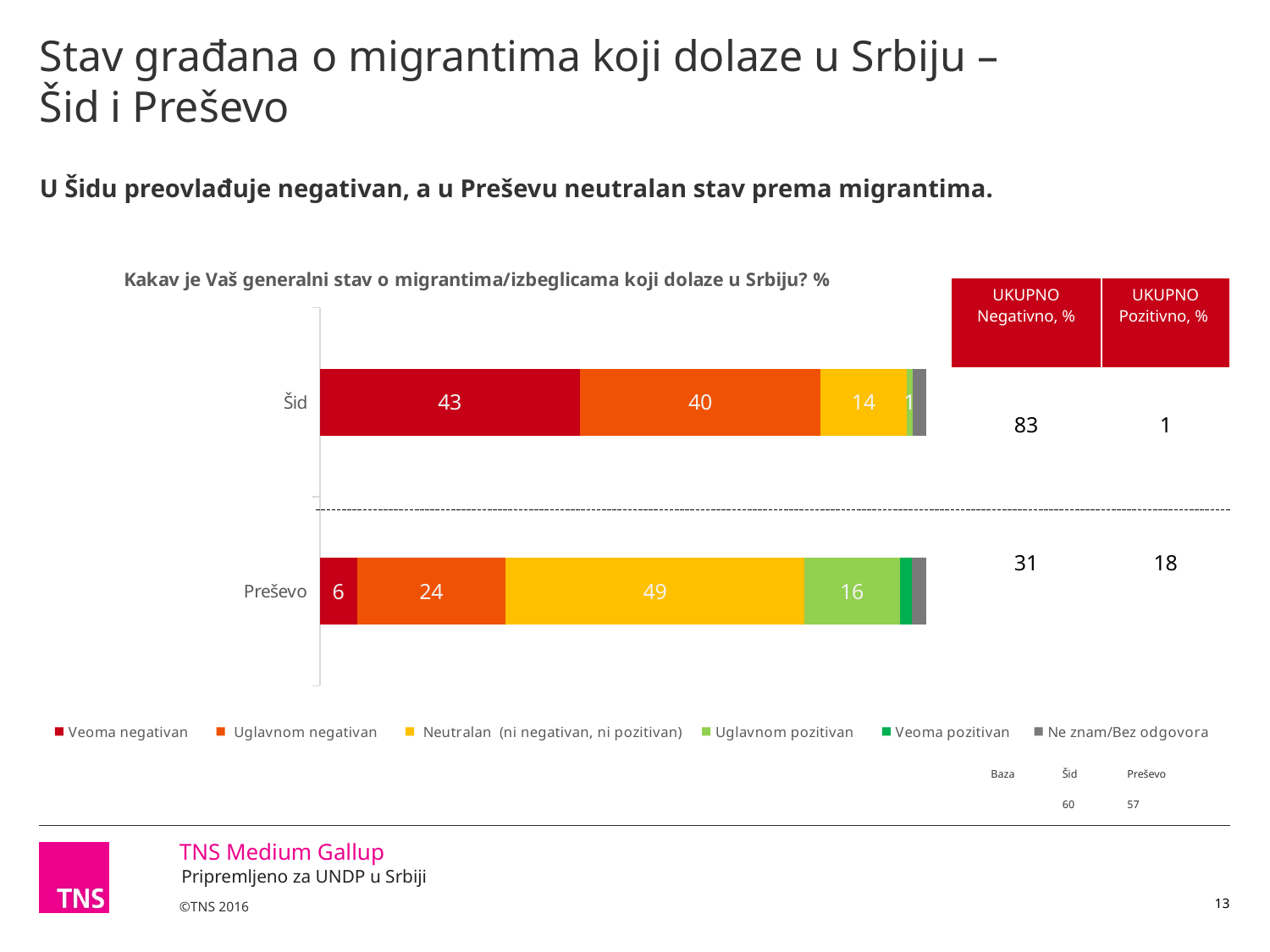
What is the value of 'Uglavnom negativan' for Šid? 40 What is the value of 'Uglavnom pozitivan' for Preševo? 16 What is the difference between the 'Neutralan' values for Preševo and Šid? 35 What is the value of 'Neutralan (ni negativan, ni pozitivan)' for Preševo? 49 What is the difference between the 'Veoma negativan' values for Šid and Preševo? 37 What is the title of the chart? Kakav je Vaš generalni stav o migrantima/izbeglicama koji dolaze u Srbiju? % What is the value of 'Veoma negativan' for Šid? 43 What is the value of 'Uglavnom negativan' for Preševo? 24 Which place has the larger 'Veoma negativan' value, Šid or Preševo? Šid What kind of chart is shown on the slide? bar chart How many categories (places) are plotted on the chart? 2 How many series does the legend list? 6